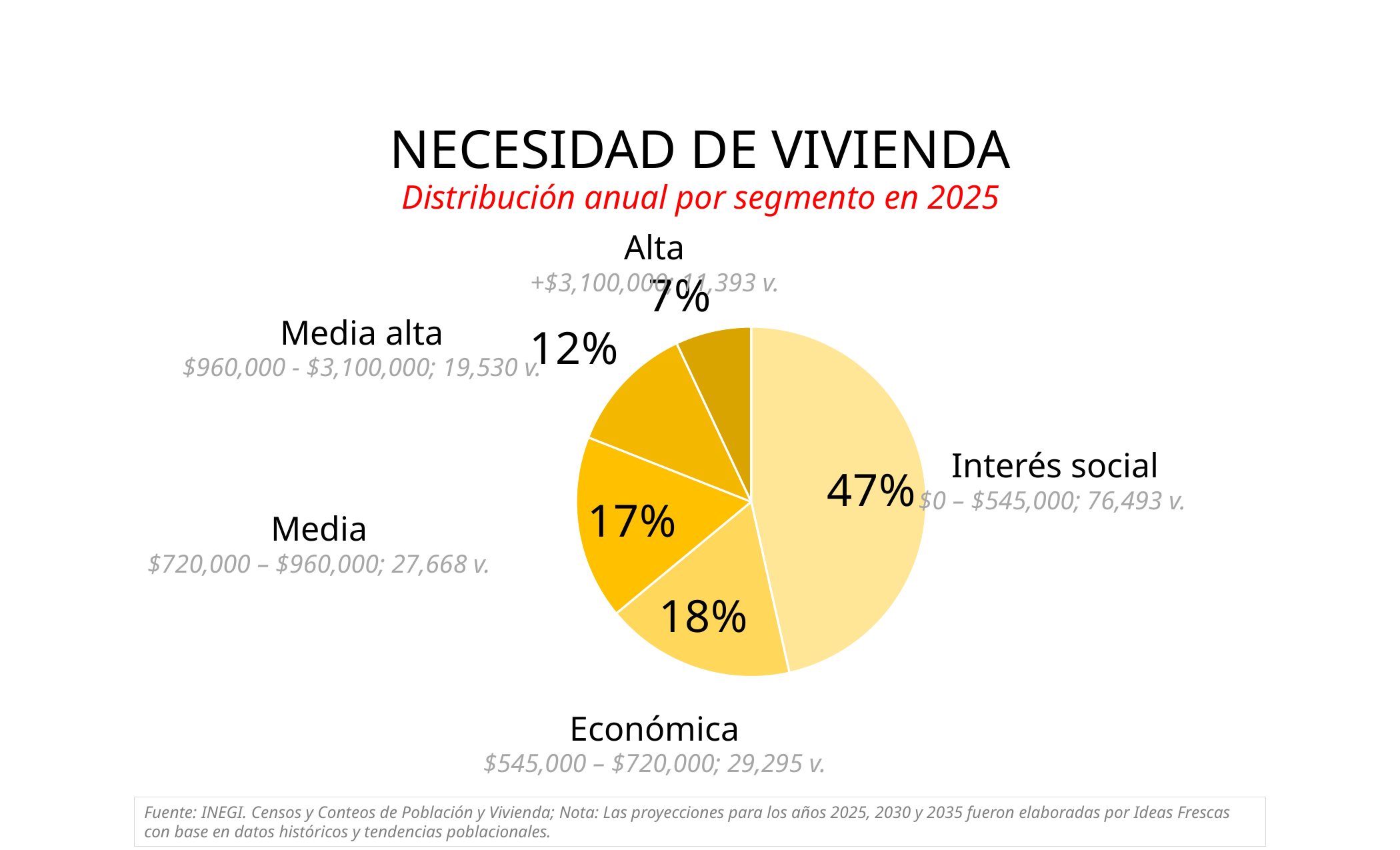
What percentage share does the Interés social segment have? 47% What percentage share does the Económica segment have? 18% How many segments does the pie chart have? 5 What percentage share does the Media alta segment have? 12% Which segment has the largest share of the pie? Interés social What is the difference in percentage points between the Interés social and Económica shares? 29 How many viviendas are listed for the Media segment? 27,668 v. What is the subtitle of the chart shown in red? Distribución anual por segmento en 2025 What kind of chart is shown on the slide? Pie chart Which segment has a larger share, Media or Media alta? Media What percentage share does the Alta segment have? 7% Which segment has the smallest share of the pie? Alta